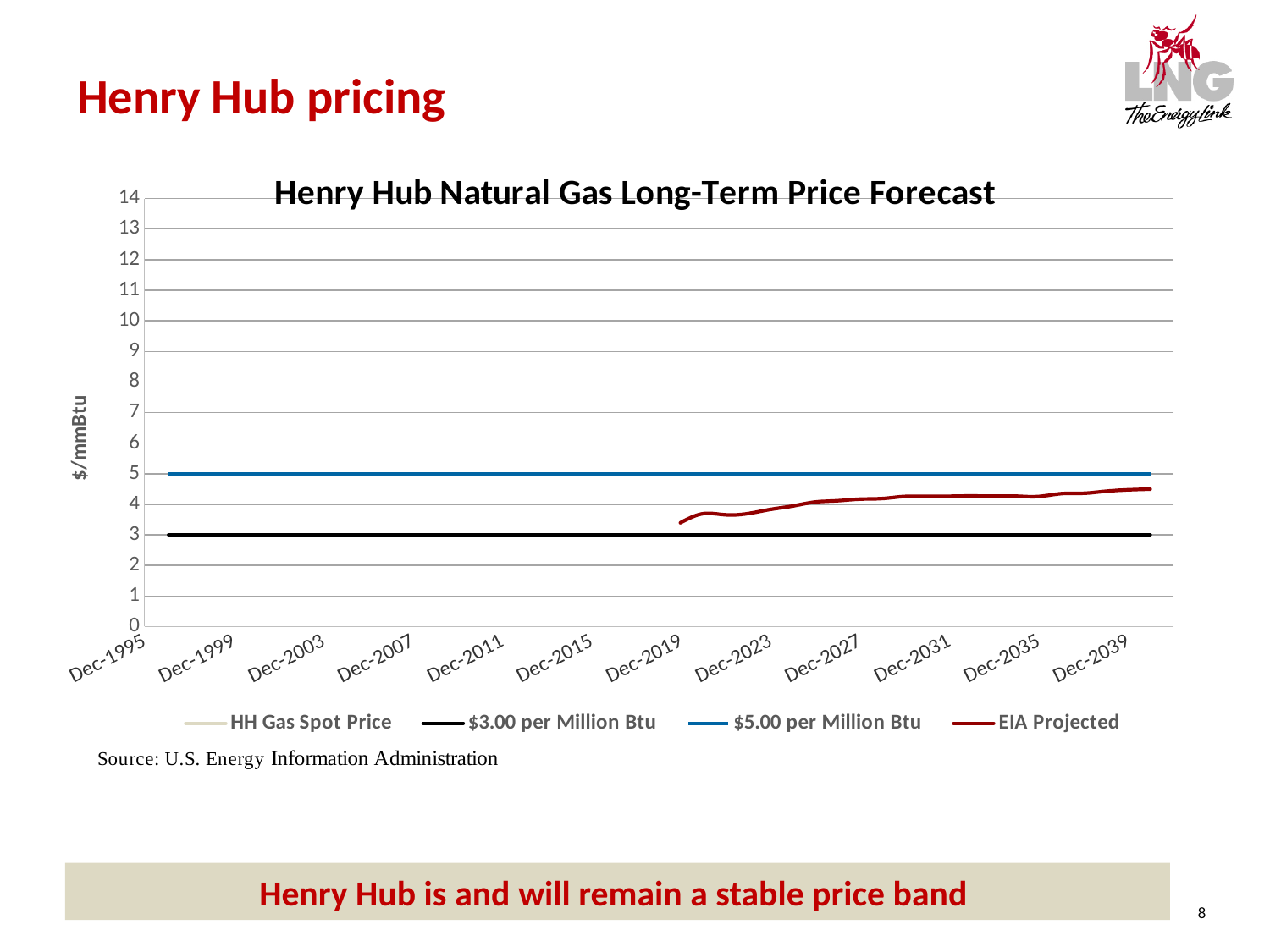
Does the EIA Projected line rise or fall from Dec-2019 to Dec-2039? rise Is the EIA Projected value at Dec-2039 greater or less than 4? greater How many date labels are shown along the horizontal axis? 12 At what value does the '$3.00 per Million Btu' line sit on the vertical axis? 3 What kind of chart is shown on the slide? line chart What is the title of the chart? Henry Hub Natural Gas Long-Term Price Forecast Is the EIA Projected value at Dec-2039 greater or less than 5? less What is the label on the vertical axis of the chart? $/mmBtu Which is higher on the chart, the '$5.00 per Million Btu' line or the '$3.00 per Million Btu' line? $5.00 per Million Btu Is the EIA Projected value at Dec-2019 greater or less than 4? less At what value does the '$5.00 per Million Btu' line sit on the vertical axis? 5 How many series does the chart legend list? 4